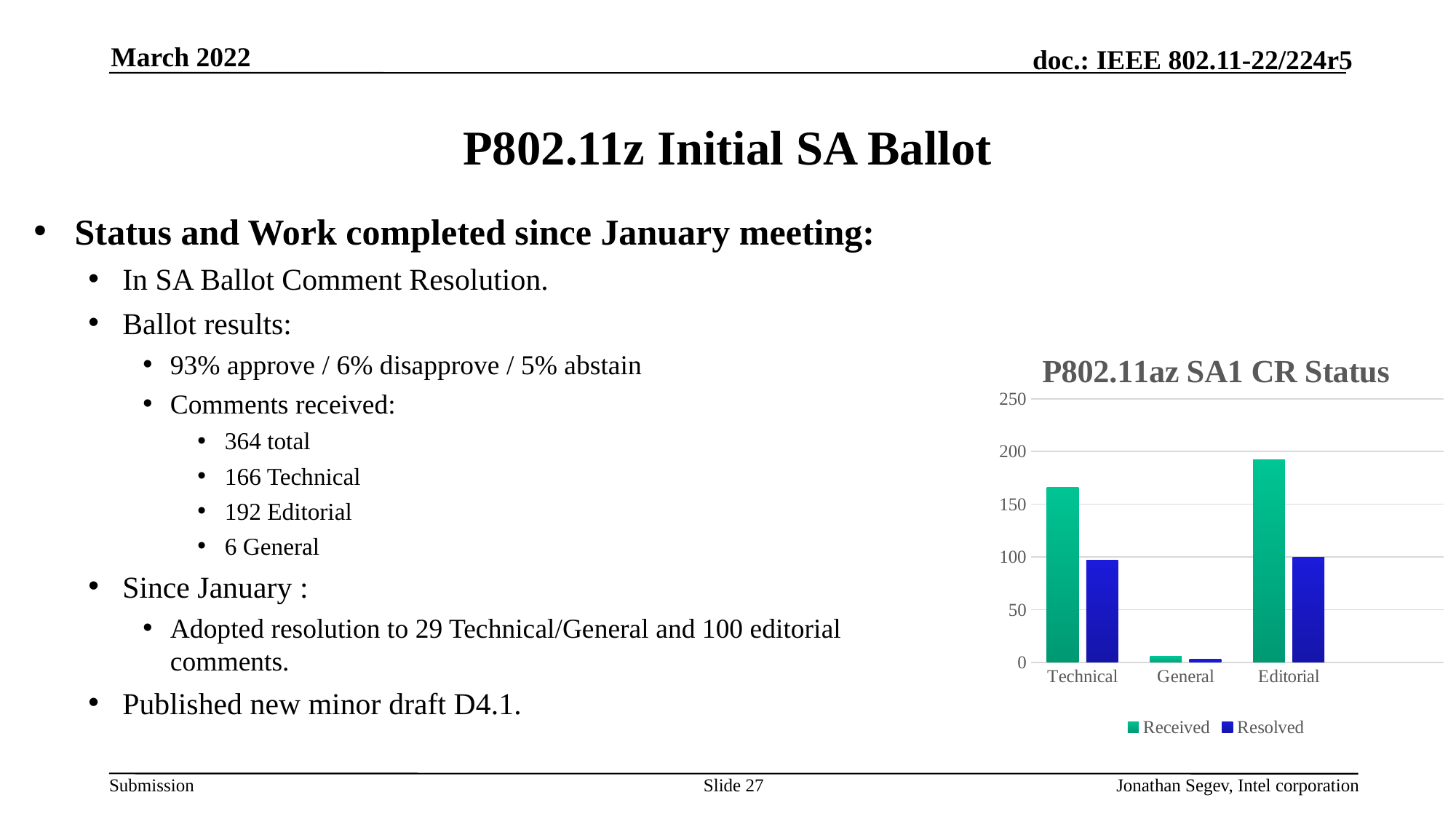
Is the Received value for Technical greater or less than 150? greater Is the Received value for General greater or less than 50? less Which category has the highest Received value? Editorial Which category has the lowest Received value? General What is the title of the chart? P802.11az SA1 CR Status Which series is shown in blue in the chart? Resolved Is the Received value for Editorial greater or less than 200? less What kind of chart is shown on the slide? bar chart How many series does the chart legend list? 2 How many categories are shown on the x axis of the chart? 3 For Technical, which is larger, Received or Resolved? Received Which category has the lowest Resolved value? General